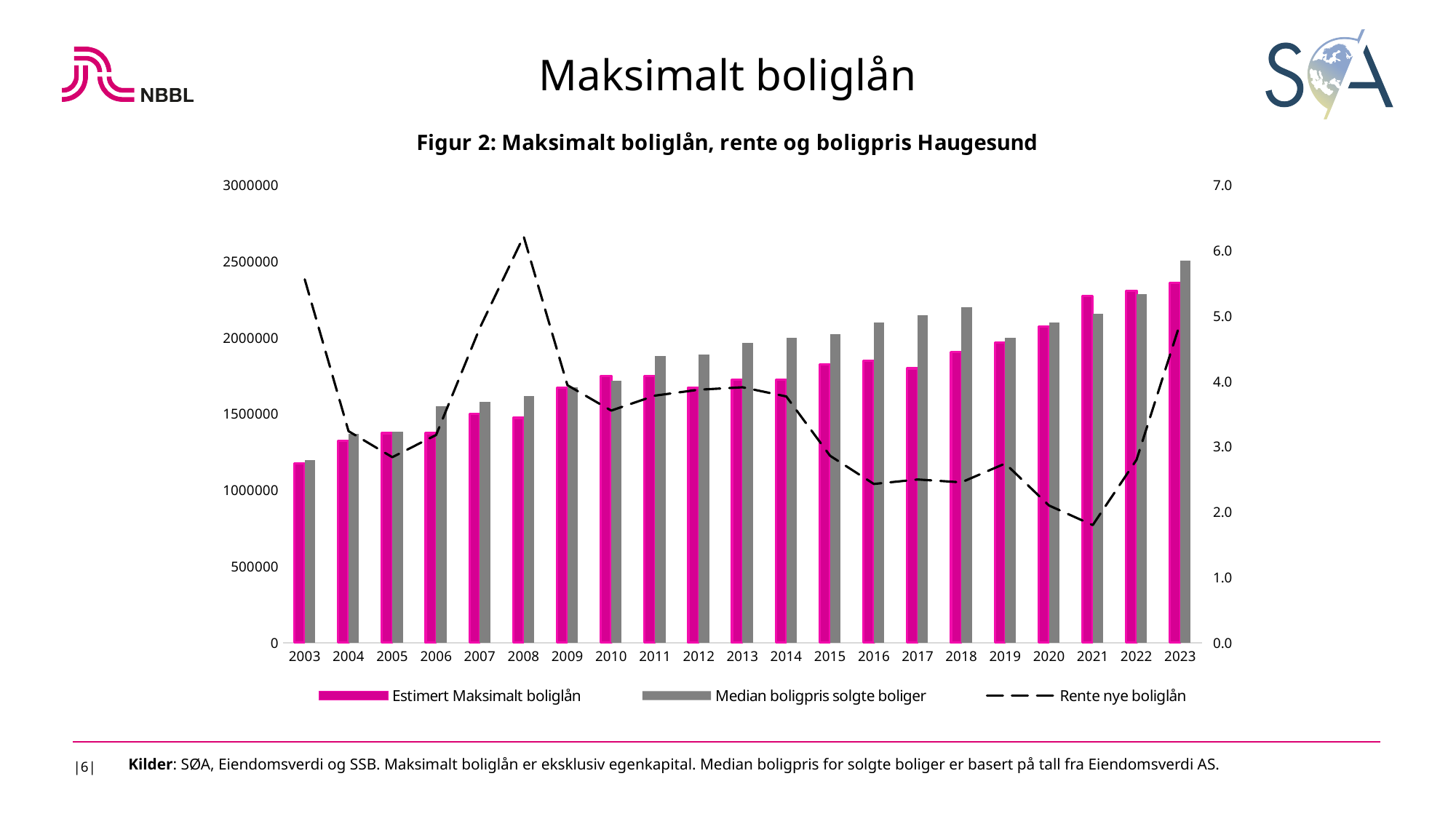
In which year is Estimert Maksimalt boliglån lowest? 2003 Is the value for Estimert Maksimalt boliglån in 2023 greater or less than 2000000? greater Does Median boligpris solgte boliger generally rise or fall from 2003 to 2023? Rise Is the value for Rente nye boliglån in 2021 greater or less than 2.0? less In which year does Rente nye boliglån reach its lowest value? 2021 What kind of chart is shown on the slide? A bar chart combined with a dashed line In 2021, which is larger: Estimert Maksimalt boliglån or Median boligpris solgte boliger? Estimert Maksimalt boliglån How many series does the legend list? 3 In which year is Median boligpris solgte boliger highest? 2023 How many years are shown on the x axis? 21 In which year is Estimert Maksimalt boliglån highest? 2023 In which year does Rente nye boliglån reach its highest value? 2008